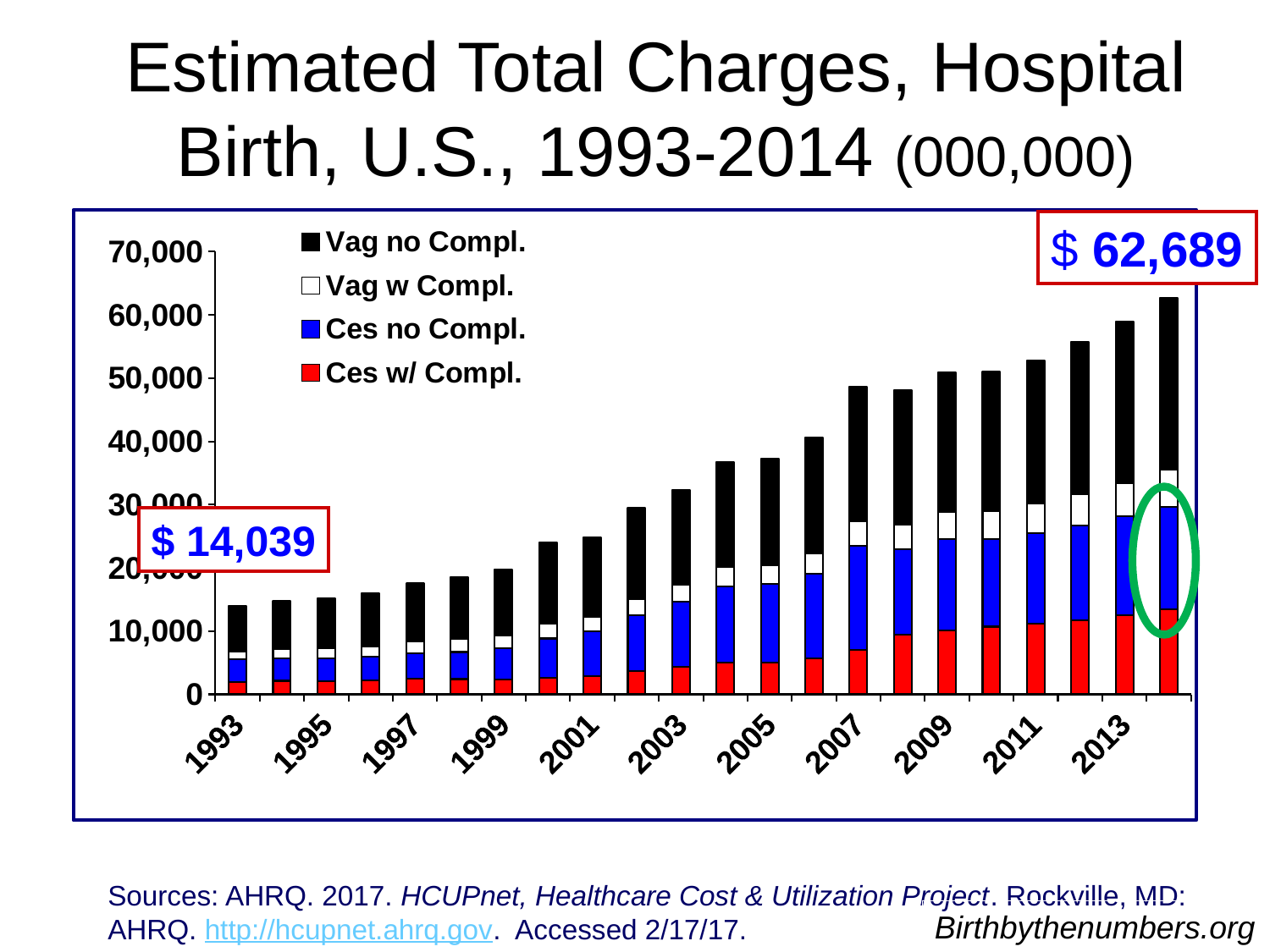
Which year has larger total charges, 2009 or 2013? 2013 How many years (bars) are plotted in the chart? 22 How many series does the legend list? 4 What is the difference between the labelled total for 2014 and the labelled total for 1993? 48,650 Do total charges generally rise or fall from 1993 to 2014? Rise Which year has the highest total charges? 2014 Is the total for 2007 greater or less than 40,000? greater What kind of chart is shown on the slide? Stacked bar chart Which year has the lowest total charges? 1993 What is the estimated total charge labelled for 2014? $ 62,689 Which colour represents 'Ces w/ Compl.' in the legend? Red What is the estimated total charge labelled for 1993? $ 14,039